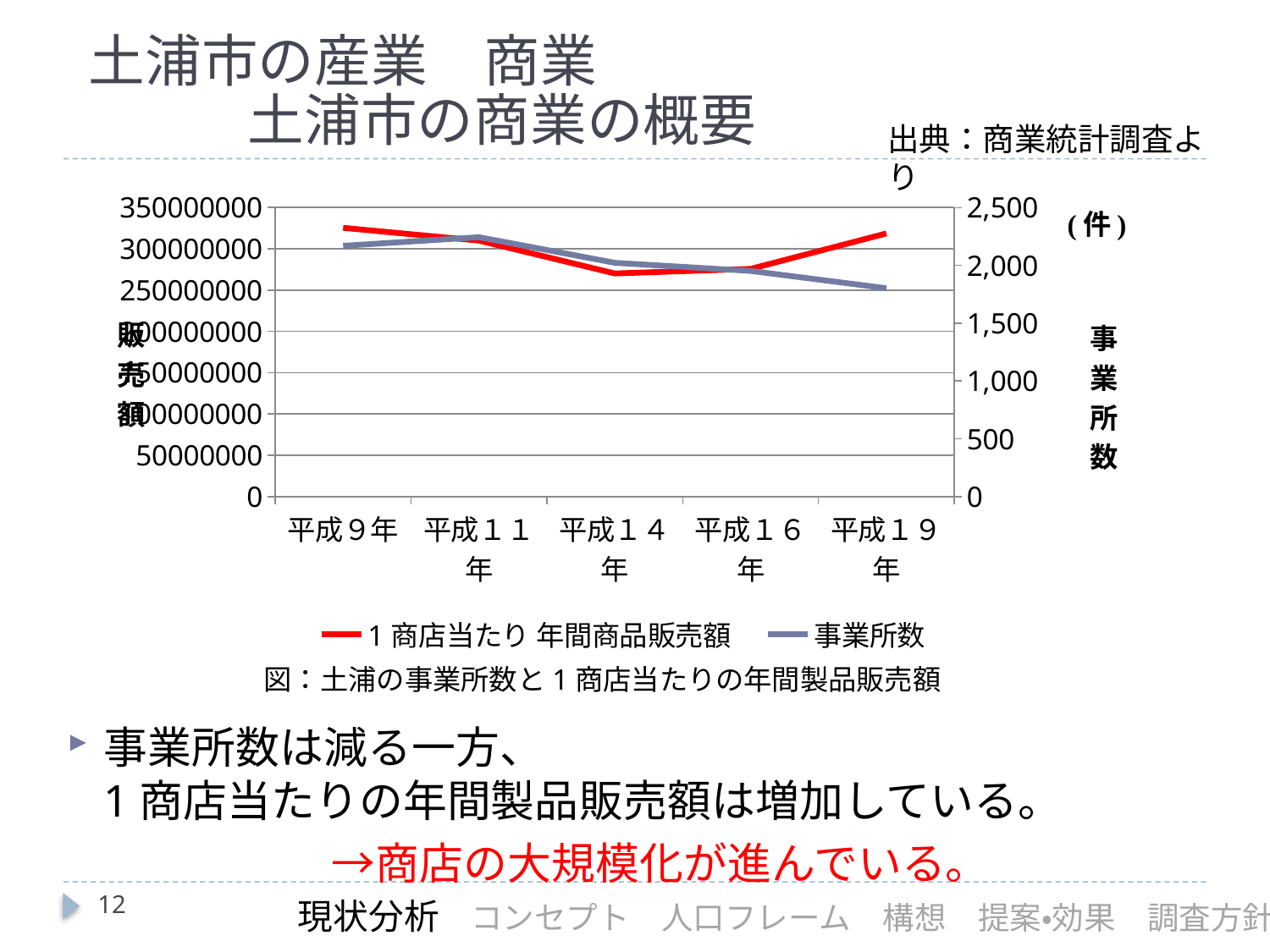
Is the value of 事業所数 for 平成19年 greater or less than 2,000? less What unit is shown next to the right-hand axis of the chart? (件) In which year is 事業所数 lowest? 平成19年 What kind of chart is shown on the slide? line chart Is the value of 1商店当たり 年間商品販売額 for 平成9年 greater or less than 300000000? greater Which series is drawn in red in the chart? 1商店当たり 年間商品販売額 Is the value of 事業所数 for 平成9年 greater or less than 2,000? greater How many years are plotted along the x axis of the chart? 5 Does 事業所数 rise or fall overall from 平成9年 to 平成19年? fall Which year has the larger value of 1商店当たり 年間商品販売額, 平成14年 or 平成19年? 平成19年 How many series does the chart legend list? 2